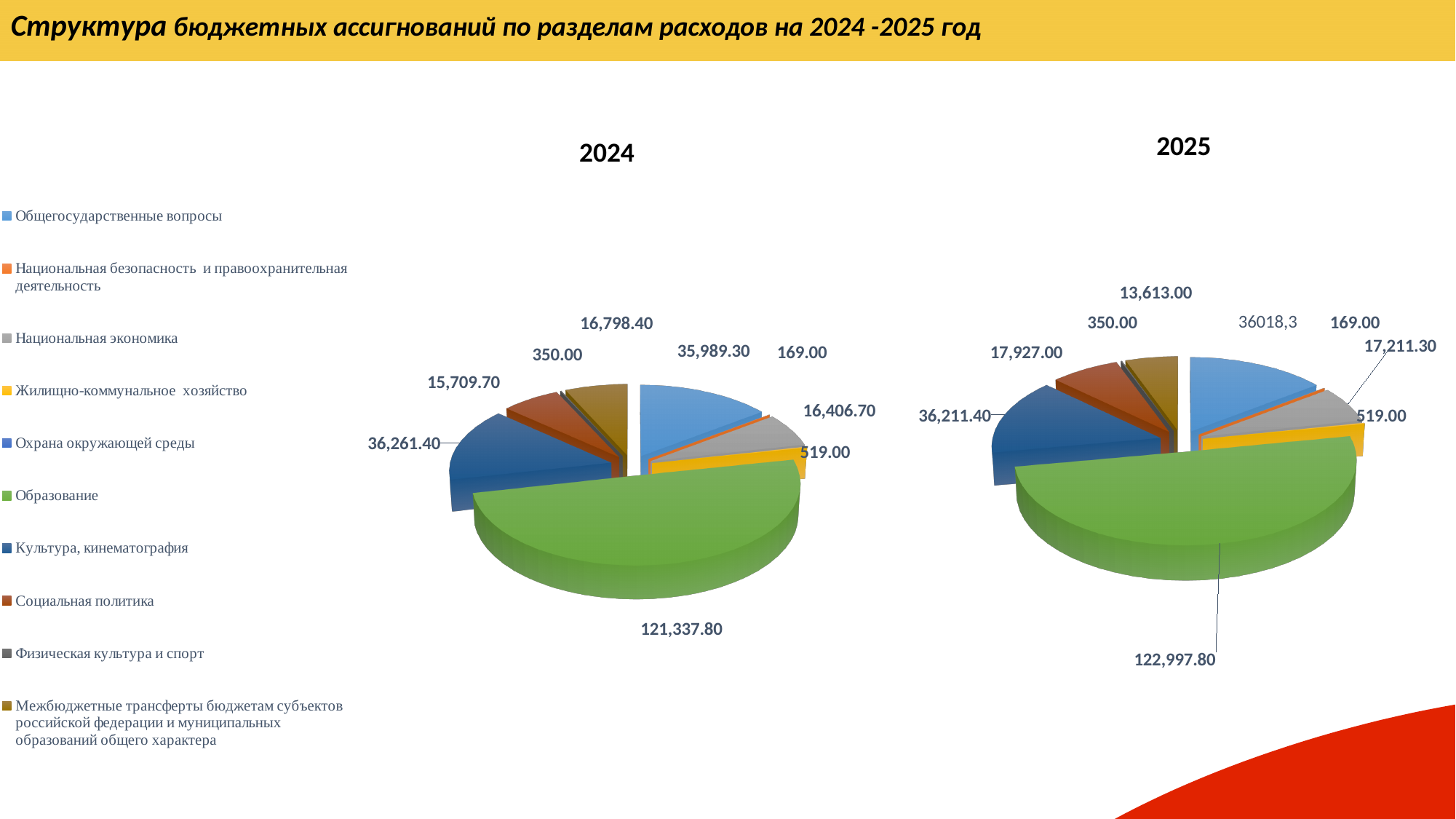
In the 2025 chart, what is the value for Образование? 122,997.80 In the 2025 chart, what is the value for Межбюджетные трансферты бюджетам субъектов российской федерации и муниципальных образований общего характера? 13,613.00 What type of chart is used for the 2024 and 2025 data on this slide? Pie chart In the 2024 chart, which category has the largest slice? Образование In the 2024 chart, which is larger: Культура, кинематография or Общегосударственные вопросы? Культура, кинематография In the 2024 chart, what is the value for Образование? 121,337.80 In the 2024 chart, what is the value for Культура, кинематография? 36,261.40 By how much does the value for Образование in the 2025 chart exceed the value in the 2024 chart? 1,660.00 In the 2025 chart, what is the value for Социальная политика? 17,927.00 In the 2025 chart, which category has the smallest labelled value? Национальная безопасность и правоохранительная деятельность In the 2024 chart, what is the difference between Культура, кинематография (36,261.40) and Общегосударственные вопросы (35,989.30)? 272.10 How many categories are listed in the legend on the slide? 10